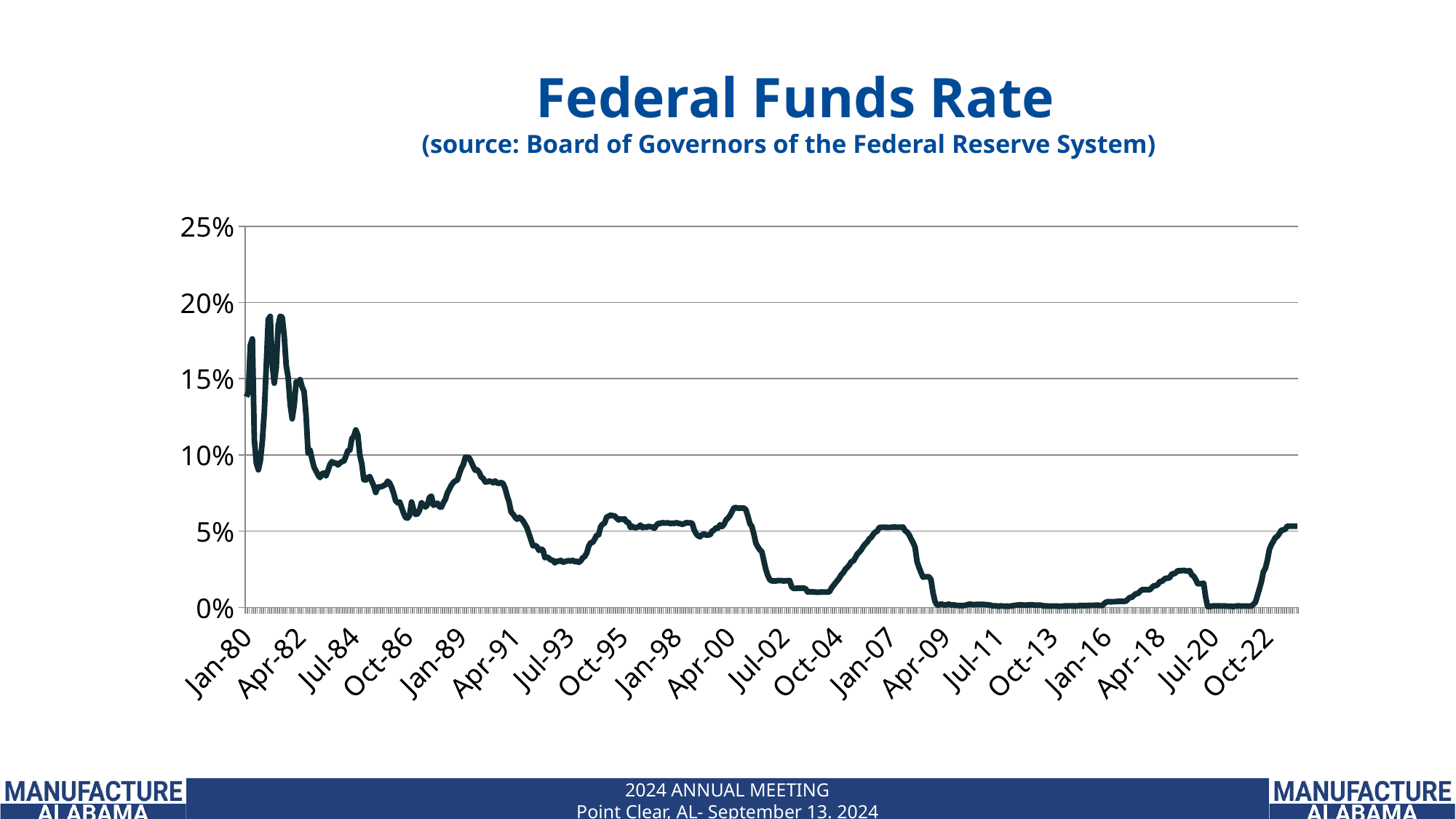
Is the value at Jan-89 greater or less than 5%? greater Between which two x-axis labels does the line reach its highest point? Jan-80 and Apr-82 Is the value at Apr-18 greater or less than 5%? less What is the title of the chart? Federal Funds Rate How many lines (data series) are plotted on the chart? 1 Is the value at Jan-80 greater or less than 10%? greater What kind of chart is shown on the slide? line chart Overall, does the Federal Funds Rate rise or fall from Jan-80 to Oct-22? fall How many date labels are shown along the x axis? 20 What source is cited for the chart data? Board of Governors of the Federal Reserve System What is the highest value shown on the y axis? 25%